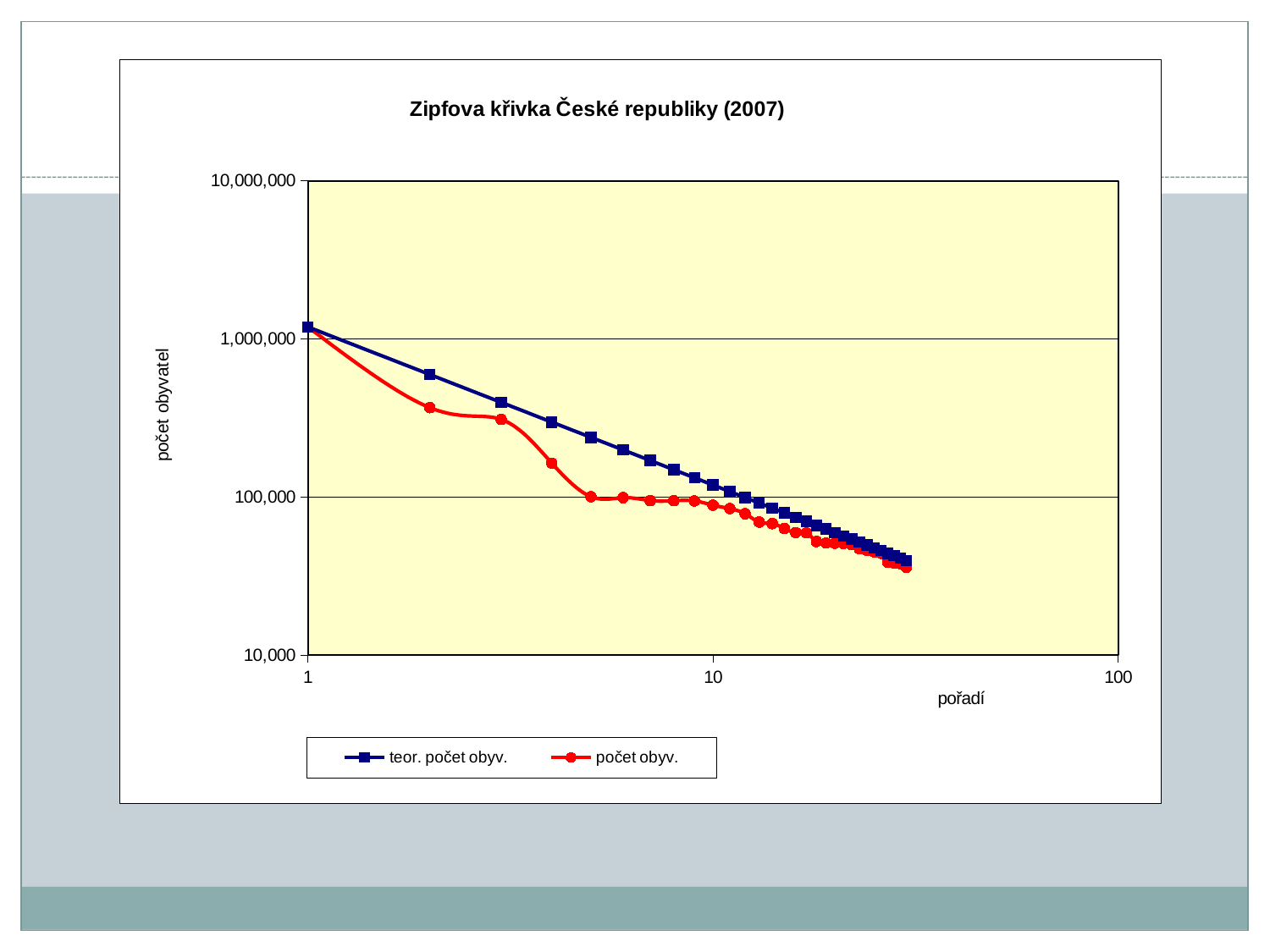
Is the value of 'počet obyv.' at pořadí 4 greater or less than 100,000? greater At pořadí 4, which series has the higher value, 'teor. počet obyv.' or 'počet obyv.'? teor. počet obyv. Is the value of 'počet obyv.' at pořadí 1 greater or less than 1,000,000? greater Is the value of 'počet obyv.' at pořadí 2 greater or less than 1,000,000? less At pořadí 2, which series has the higher value, 'teor. počet obyv.' or 'počet obyv.'? teor. počet obyv. How many series does the legend list? 2 Do the values of the 'teor. počet obyv.' series rise or fall along the x axis? fall What is the title of the chart? Zipfova křivka České republiky (2007) What kind of chart is shown on the slide? line chart What is the label of the y axis? počet obyvatel Do the values of the 'počet obyv.' series rise or fall as pořadí increases? fall